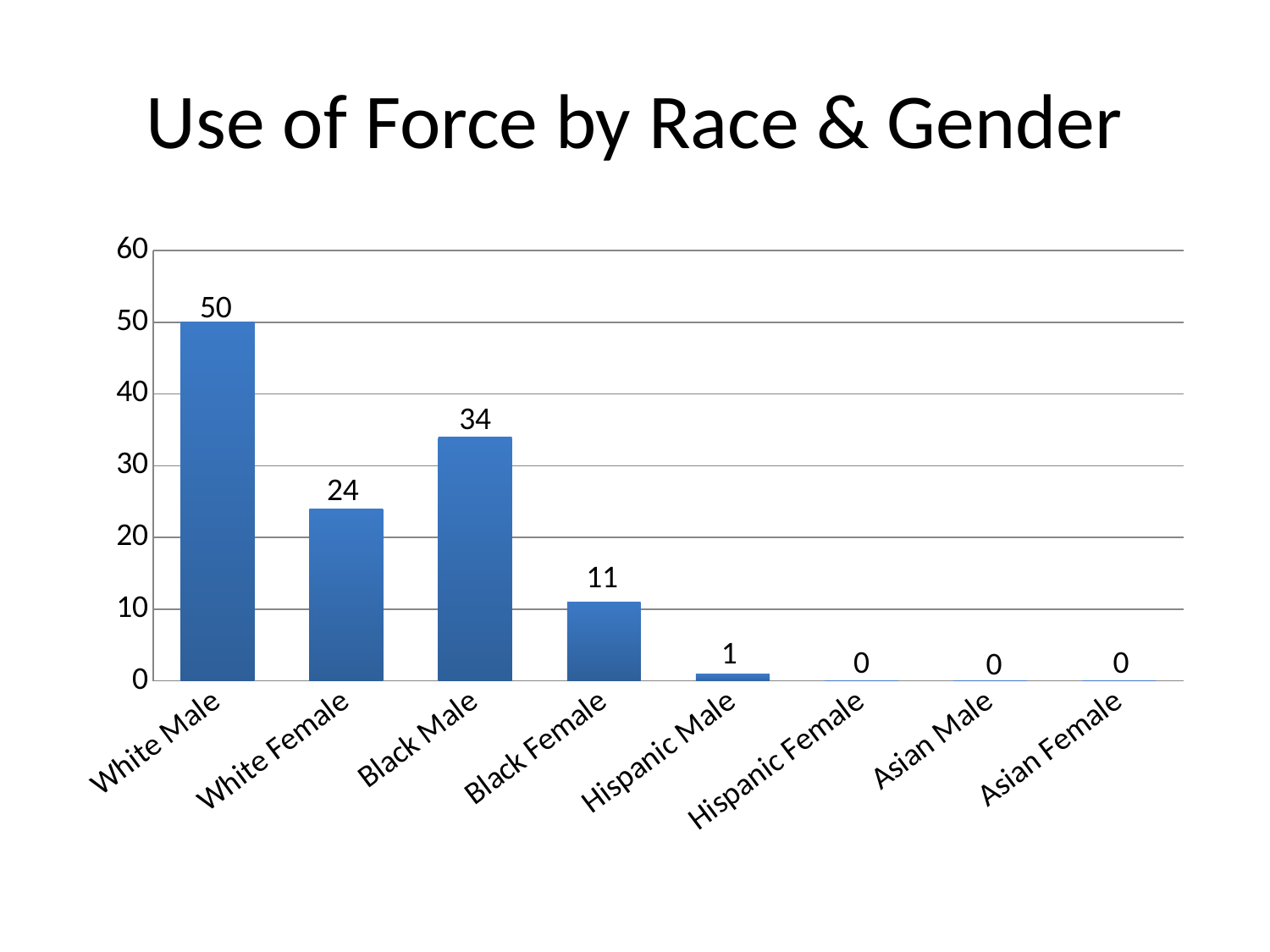
What is the title of the chart? Use of Force by Race & Gender What is the difference between the values for White Male and Black Male? 16 How many categories have a value of 0? 3 What is the difference between the values for White Female and Black Female? 13 Which category has the highest value? White Male What is the value for White Male? 50 What is the value for Hispanic Male? 1 What is the value for Black Female? 11 Is the value for Black Male greater or less than 30? greater What kind of chart is shown on the slide? bar chart Which is larger, the value for White Female or the value for Black Male? Black Male How many categories are shown on the x axis? 8